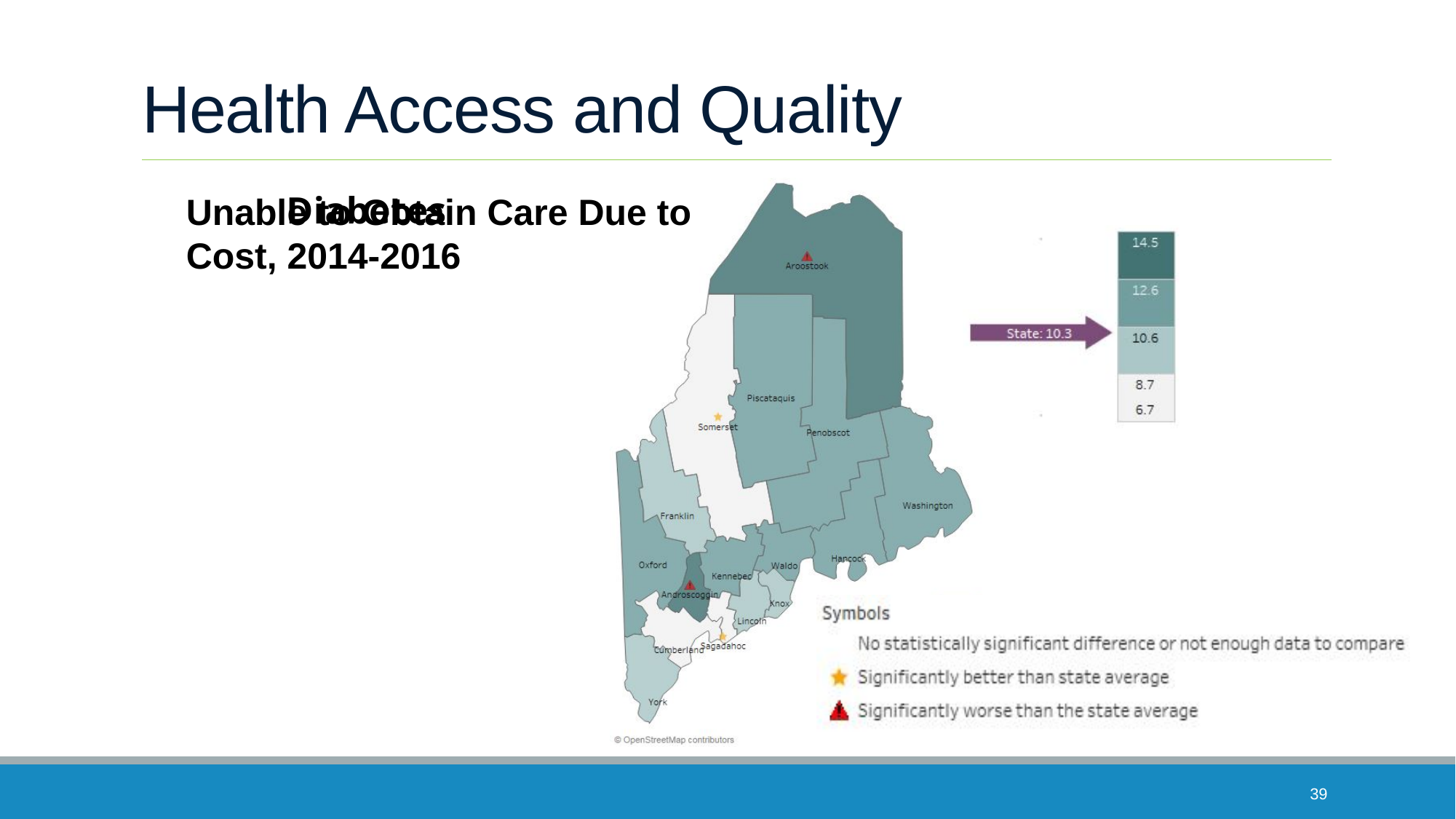
What is the lowest value shown on the map's colour legend? 6.7 Which counties are marked with a red triangle as significantly worse than the state average? Aroostook and Androscoggin What is the highest value shown on the map's colour legend? 14.5 Which counties are marked with a star as significantly better than the state average? Somerset and Sagadahoc What time period does the map title give? 2014-2016 What is the state value shown by the arrow next to the legend? State: 10.3 How many counties are labelled on the map? 16 How many shade levels does the colour legend show? 5 What kind of chart is shown on the slide? A map (choropleth map of Maine counties) According to the Symbols key, what does the star symbol mean? Significantly better than state average